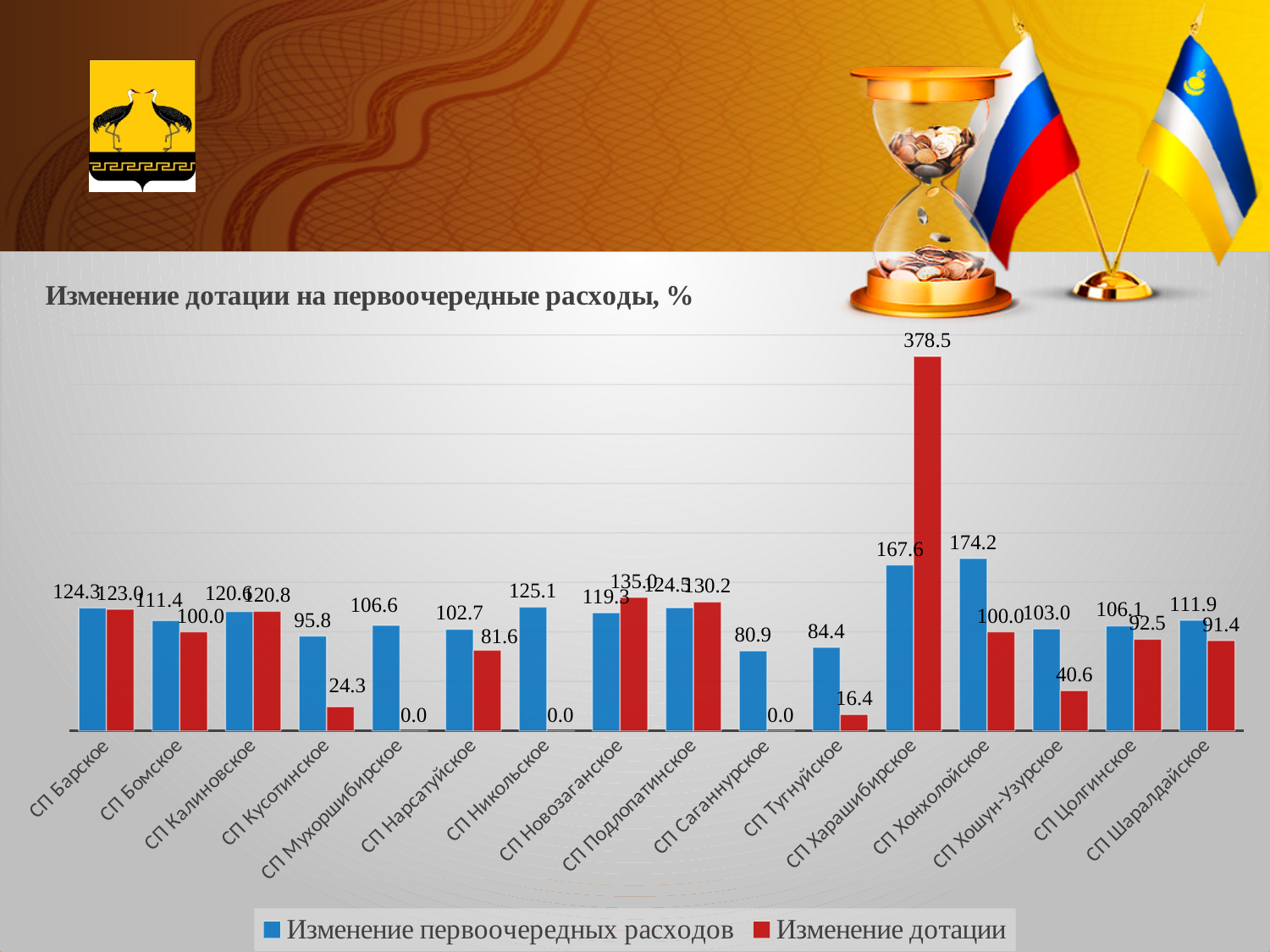
What kind of chart is shown on the slide? Bar chart What is the value of Изменение дотации for СП Кусотинское? 24.3 What is the value of Изменение первоочередных расходов for СП Хонхолойское? 174.2 Which category has the lowest value for Изменение первоочередных расходов? СП Саганнурское Which category has the highest value for Изменение первоочередных расходов? СП Хонхолойское What is the difference between Изменение дотации and Изменение первоочередных расходов for СП Харашибирское? 210.9 For СП Тугнуйское, which is larger: Изменение первоочередных расходов or Изменение дотации? Изменение первоочередных расходов How many series does the legend list? 2 What is the value of Изменение первоочередных расходов for СП Саганнурское? 80.9 Which category has the highest value for Изменение дотации? СП Харашибирское How many categories are shown on the x axis? 16 What is the value of Изменение дотации for СП Харашибирское? 378.5